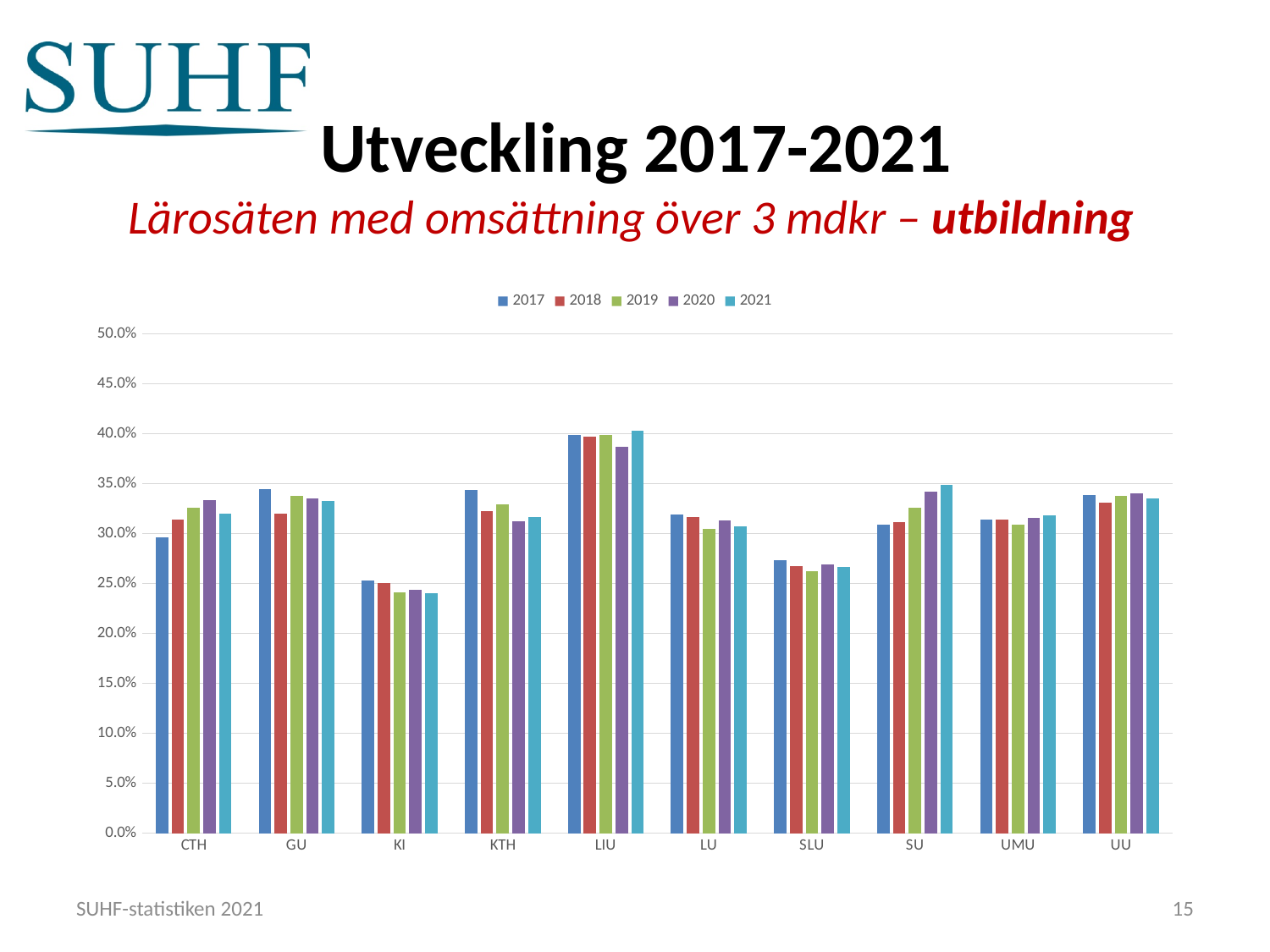
For SU, do the values rise or fall from 2017 to 2021? rise Which institution has the highest values across all years? LIU Which is larger for KTH, the 2017 value or the 2021 value? 2017 Which is larger, the 2017 value for CTH or the 2017 value for GU? GU How many institutions (categories) are shown on the x axis? 10 What kind of chart is shown on the slide? bar chart Is the value for KI in 2017 greater or less than 30.0%? less Is the value for SLU in 2017 greater or less than 30.0%? less Is the value for LIU in 2017 greater or less than 35.0%? greater Which institution has the lowest values across all years? KI How many series does the legend list? 5 Which years are listed in the chart legend? 2017, 2018, 2019, 2020, 2021